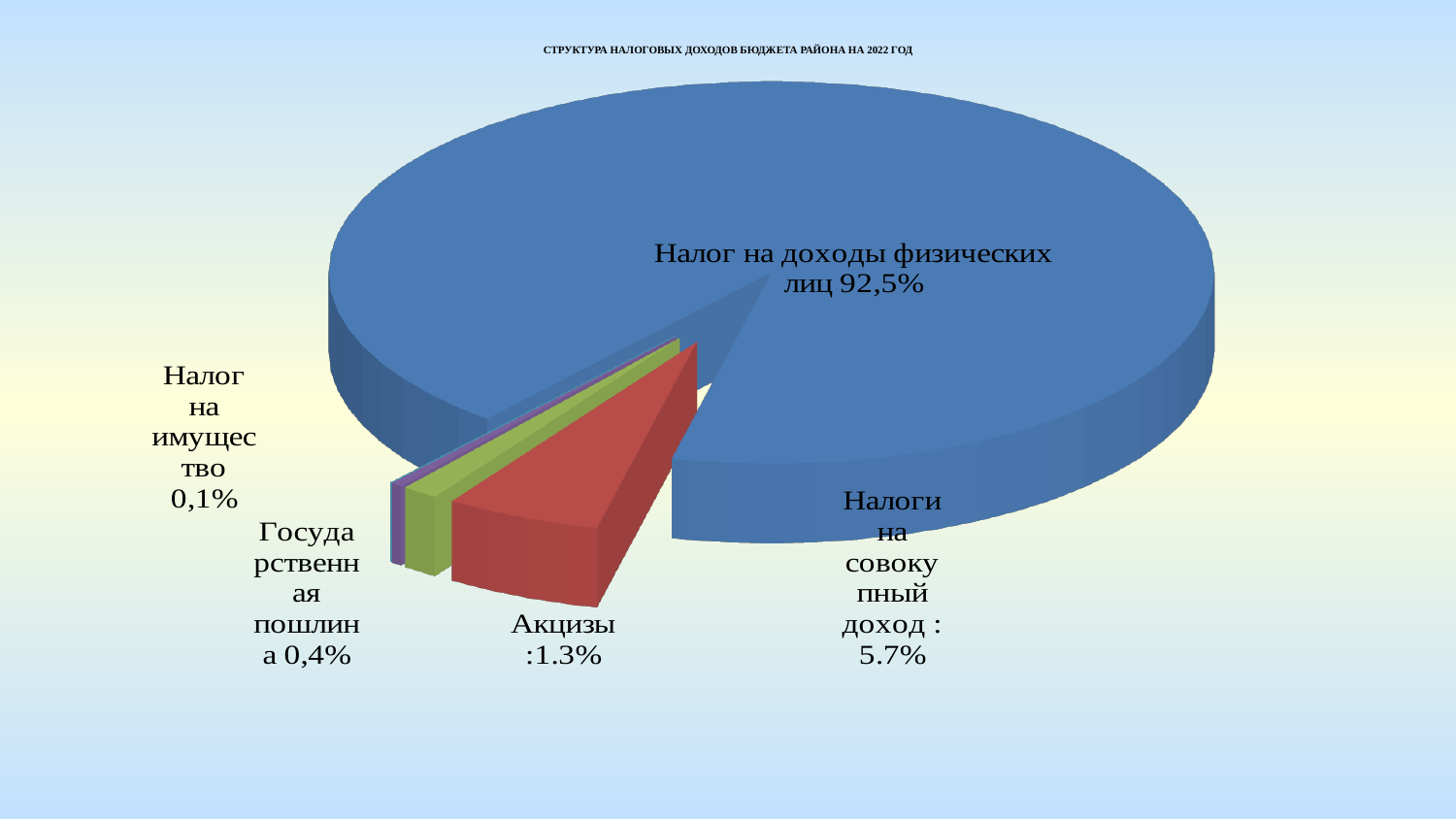
What is the title of the chart? СТРУКТУРА НАЛОГОВЫХ ДОХОДОВ БЮДЖЕТА РАЙОНА НА 2022 ГОД Which category has the largest slice of the pie? Налог на доходы физических лиц Which category has the smallest slice of the pie? Налог на имущество Which is larger, Акцизы or Налоги на совокупный доход? Налоги на совокупный доход What is the value shown for Налог на имущество? 0,1% What is the value shown for Налоги на совокупный доход? 5.7% What is the value shown for Государственная пошлина? 0,4% What is the value shown for Акцизы? 1.3% What kind of chart is shown on the slide? Pie chart What share of the pie does Налог на доходы физических лиц represent? 92,5% What is the difference between the values for Налоги на совокупный доход and Акцизы? 4.4% How many slices does the pie chart have? 5